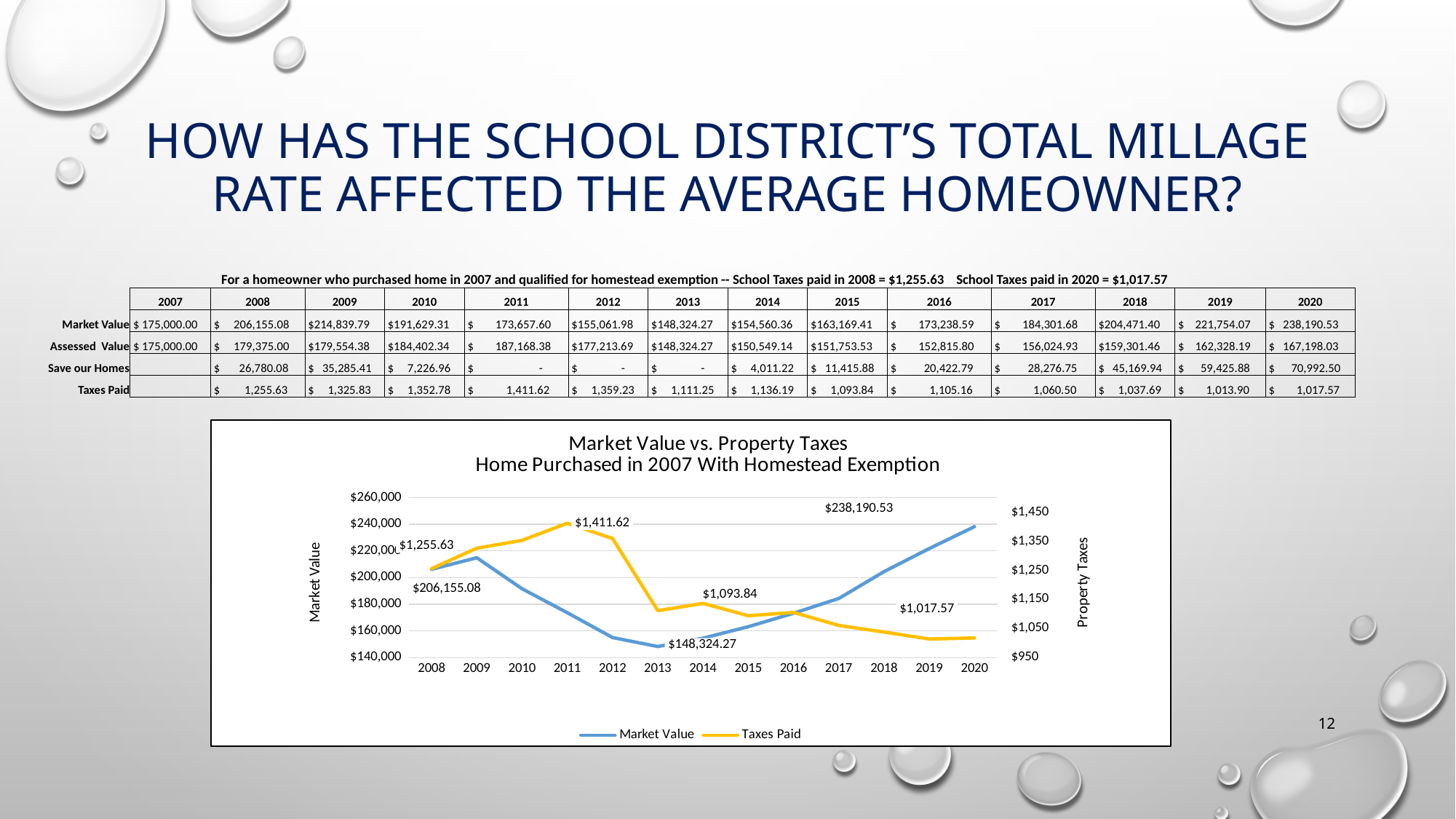
What are the two series named in the chart legend? Market Value and Taxes Paid What is the Taxes Paid value labelled for 2020 in the chart? $1,017.57 What is the Taxes Paid value labelled for 2011 in the chart? $1,411.62 What is the Market Value labelled for 2020 in the chart? $238,190.53 What is the Market Value labelled for 2008 in the chart? $206,155.08 Is the Market Value for 2012 greater or less than $160,000? less In which year does the Market Value line reach its lowest point? 2013 How many years are shown along the x axis of the chart? 13 What is the difference between the Market Value in 2020 and the Market Value in 2013, using the labelled values? $89,866.26 How many series does the chart legend list? 2 What type of chart is shown on the slide? Line chart In which year does the Taxes Paid line reach its highest point? 2011